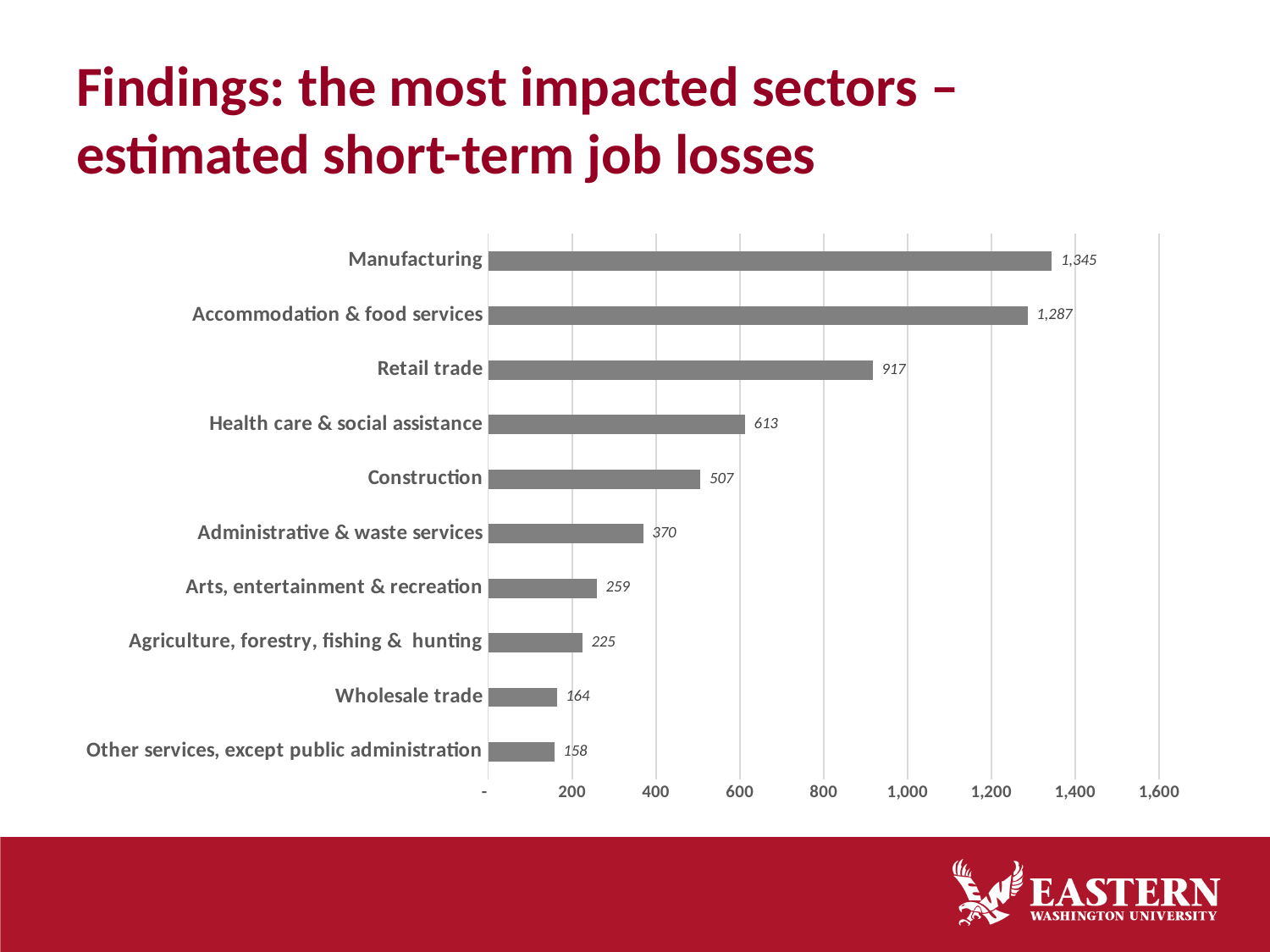
What is the value shown for Construction? 507 What is the value shown for Wholesale trade? 164 Which sector has the highest estimated short-term job losses? Manufacturing Is the value for Health care & social assistance greater or less than 600? greater Which is larger, the value for Administrative & waste services or the value for Arts, entertainment & recreation? Administrative & waste services Which sector has the lowest estimated short-term job losses? Other services, except public administration What is the value shown for Retail trade? 917 What is the difference between the values for Manufacturing and Accommodation & food services? 58 What kind of chart is shown on the slide? Bar chart What is the estimated short-term job loss for Manufacturing? 1,345 What is the difference between the values for Retail trade and Health care & social assistance? 304 How many sectors are shown in the chart? 10